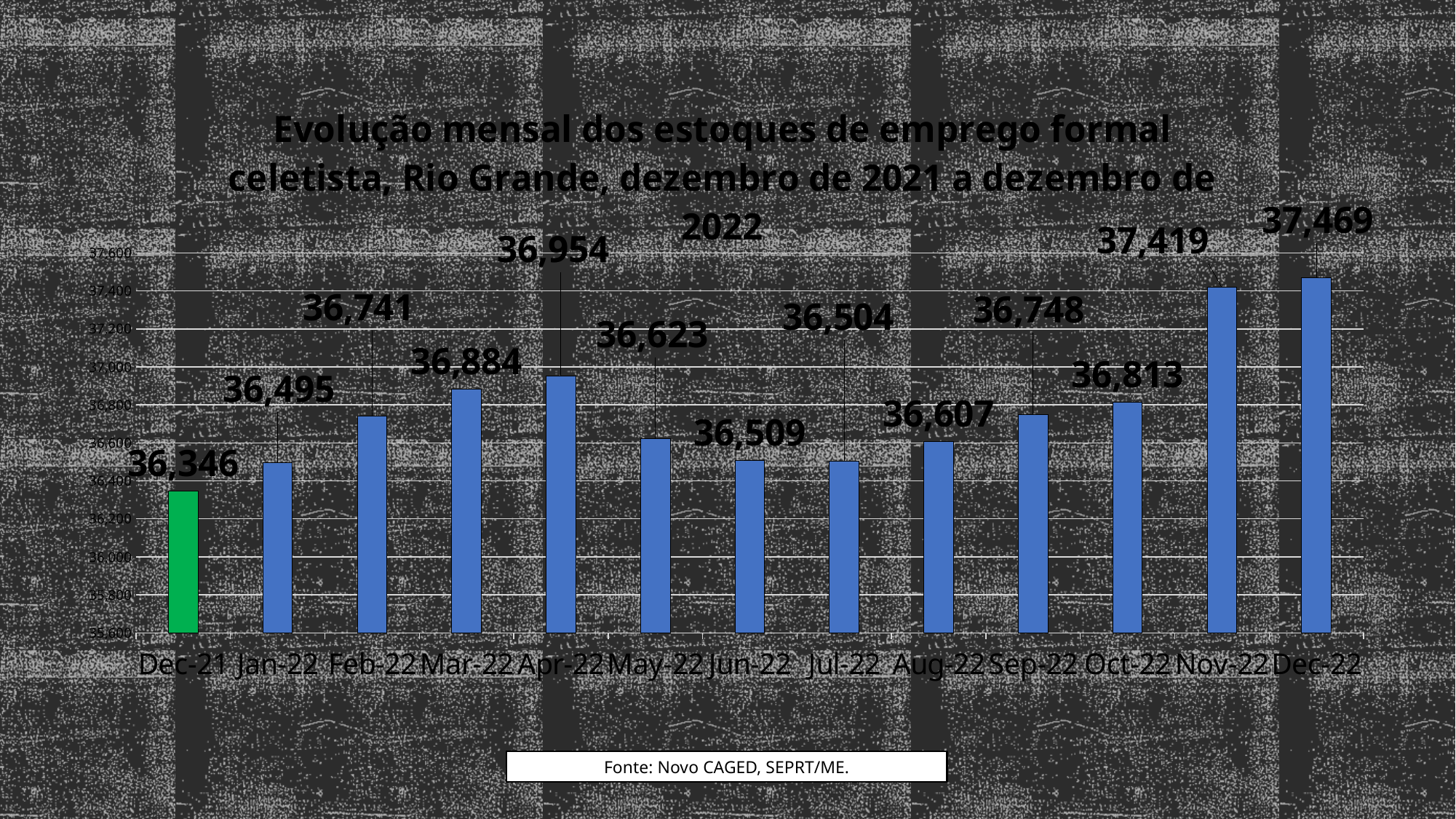
What is the difference between the values for Dec-22 and Dec-21? 1,123 What is the difference between the values for Dec-22 and Nov-22? 50 What is the value for Apr-22? 36,954 How many months are shown on the x axis? 13 Which month has the highest value? Dec-22 Which bar is coloured green rather than blue? Dec-21 Which is larger, the value for Feb-22 or the value for Sep-22? Sep-22 What is the value for Jul-22? 36,504 What kind of chart is shown on the slide? Bar chart Which month has the lowest value? Dec-21 Is the value for Nov-22 greater or less than 37,000? greater What is the value for Dec-21? 36,346